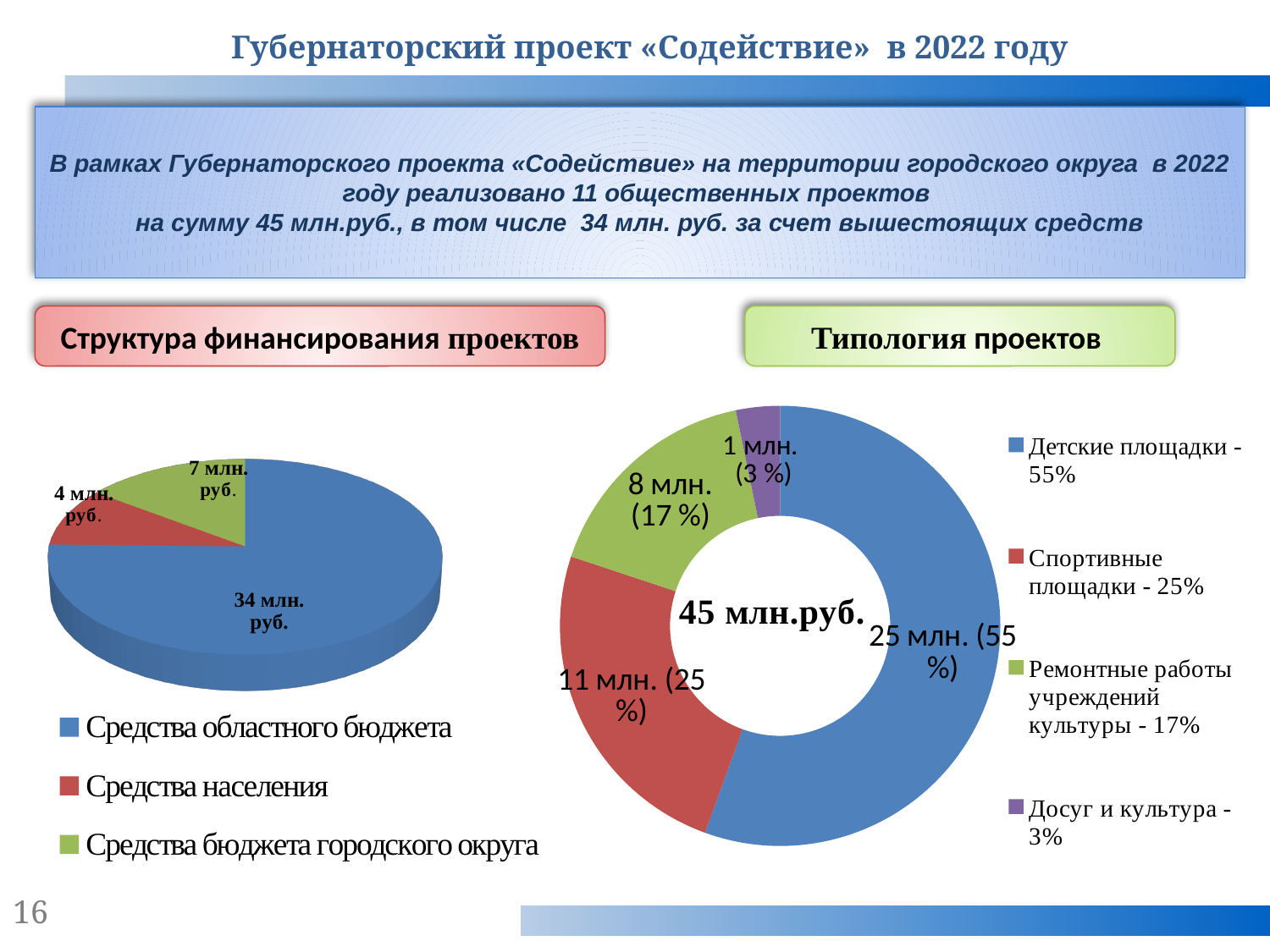
In the chart 'Структура финансирования проектов', which category has the largest slice? Средства областного бюджета In the chart 'Структура финансирования проектов', what is the value for 'Средства областного бюджета'? 34 млн. руб. In the chart 'Структура финансирования проектов', what is the difference between 'Средства бюджета городского округа' and 'Средства населения'? 3 млн. руб. In the chart 'Типология проектов', what total is shown in the centre of the doughnut? 45 млн.руб. In the chart 'Типология проектов', which category has the smallest share? Досуг и культура In the chart 'Структура финансирования проектов', which category has the smallest slice? Средства населения What kind of chart is 'Структура финансирования проектов'? Pie chart In the chart 'Типология проектов', what is the value for 'Спортивные площадки'? 11 млн. (25 %) In the chart 'Типология проектов', which is larger: 'Ремонтные работы учреждений культуры' or 'Спортивные площадки'? Спортивные площадки In the chart 'Типология проектов', what share of the total do 'Детские площадки' represent? 55% In the chart 'Структура финансирования проектов', what is the value for 'Средства населения'? 4 млн. руб. In the chart 'Структура финансирования проектов', how many categories does the legend list? 3